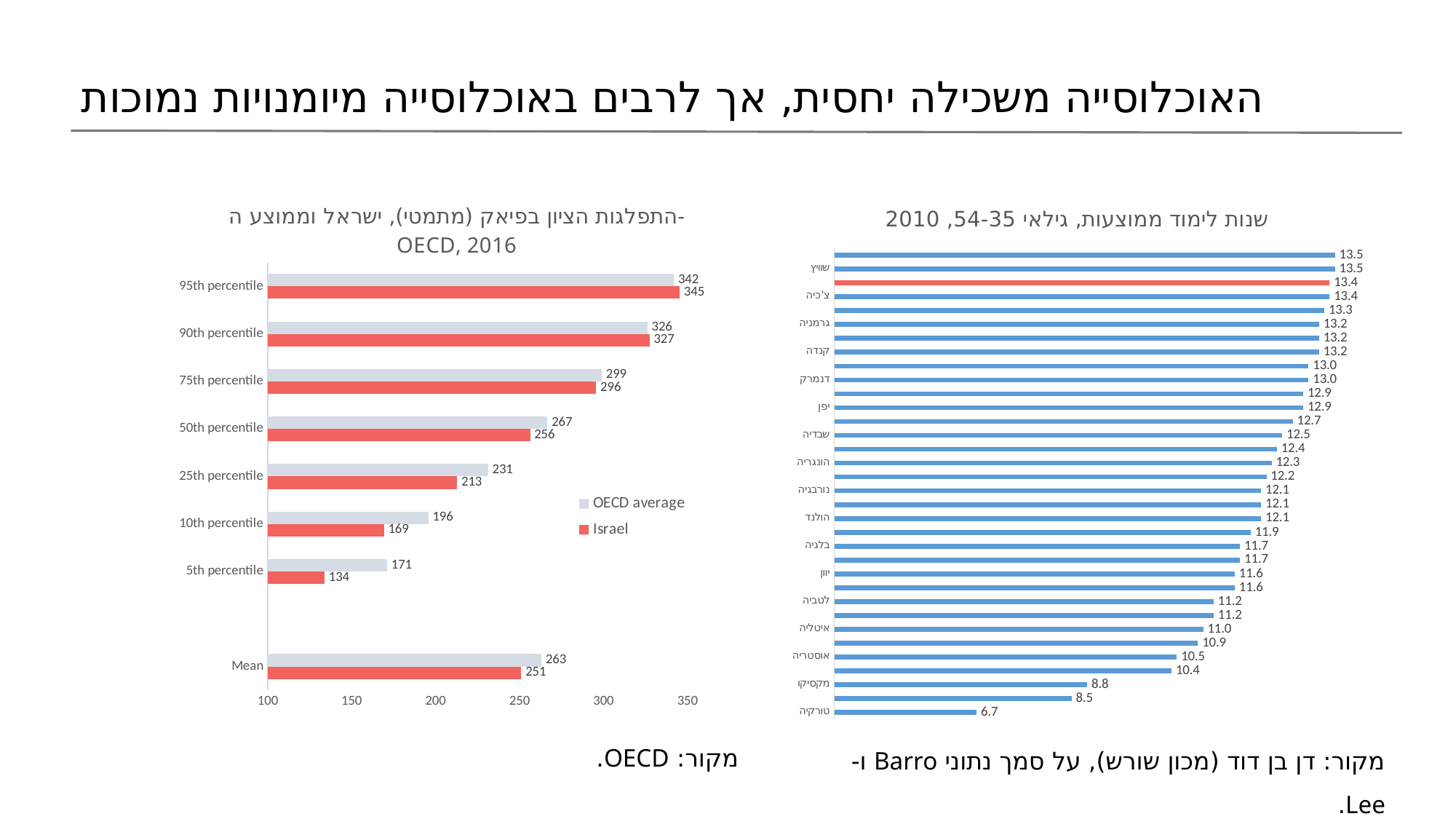
How many categories are shown on the vertical axis of the left chart (PIAAC score distribution, 2016)? 8 In the left chart (PIAAC score distribution, 2016), what is Israel's value at the 95th percentile? 345 What kind of chart is the left chart (PIAAC score distribution, 2016)? Bar chart In the right chart (average years of schooling, ages 35-54, 2010), what is the value of the red bar? 13.4 In the left chart (PIAAC score distribution, 2016), which is larger at the 25th percentile: the OECD average or Israel? OECD average In the left chart (PIAAC score distribution, 2016), at which percentile is Israel's value the lowest? 5th percentile How many series does the legend of the left chart (PIAAC score distribution, 2016) list? 2 In the left chart (PIAAC score distribution, 2016), what is Israel's Mean value? 251 In the right chart (average years of schooling, ages 35-54, 2010), what is the highest value shown? 13.5 In the left chart (PIAAC score distribution, 2016), what is the difference between the OECD average and Israel at the 10th percentile? 27 In the right chart (average years of schooling, ages 35-54, 2010), what is the value for טורקיה (Turkey), the lowest bar? 6.7 In the left chart (PIAAC score distribution, 2016), what is the OECD average at the 5th percentile? 171